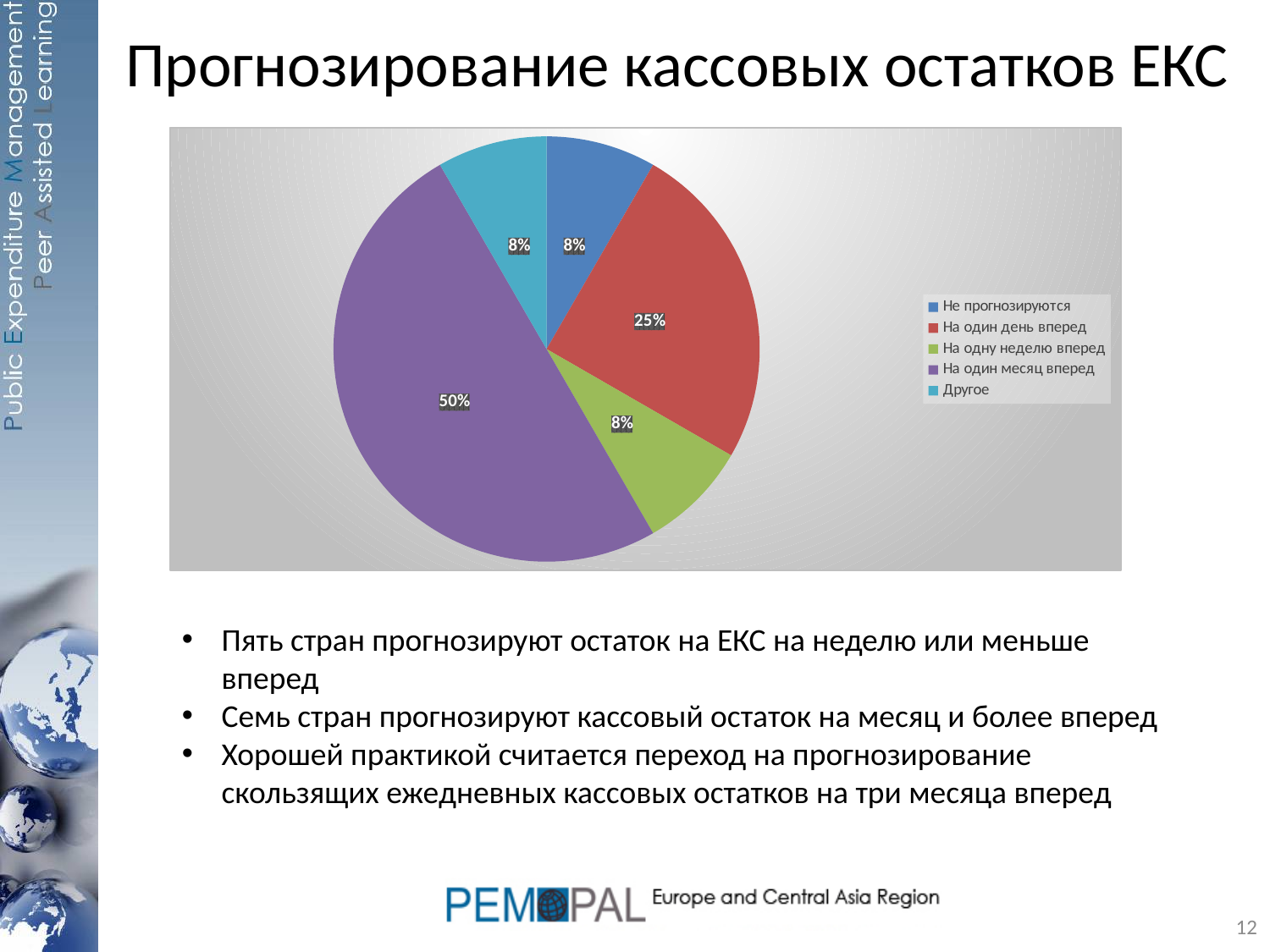
What share of the pie does "На одну неделю вперед" have? 8% What colour is the slice for "На один месяц вперед"? purple How many slices does the pie chart have? 5 What is the difference between the shares of "На один месяц вперед" and "На один день вперед"? 25% Which category has the largest slice of the pie? На один месяц вперед Which is larger, the share for "На один день вперед" or the share for "Другое"? На один день вперед What share of the pie does "Другое" have? 8% What share of the pie does "На один день вперед" have? 25% What type of chart is shown on the slide? pie chart How many entries does the legend list? 5